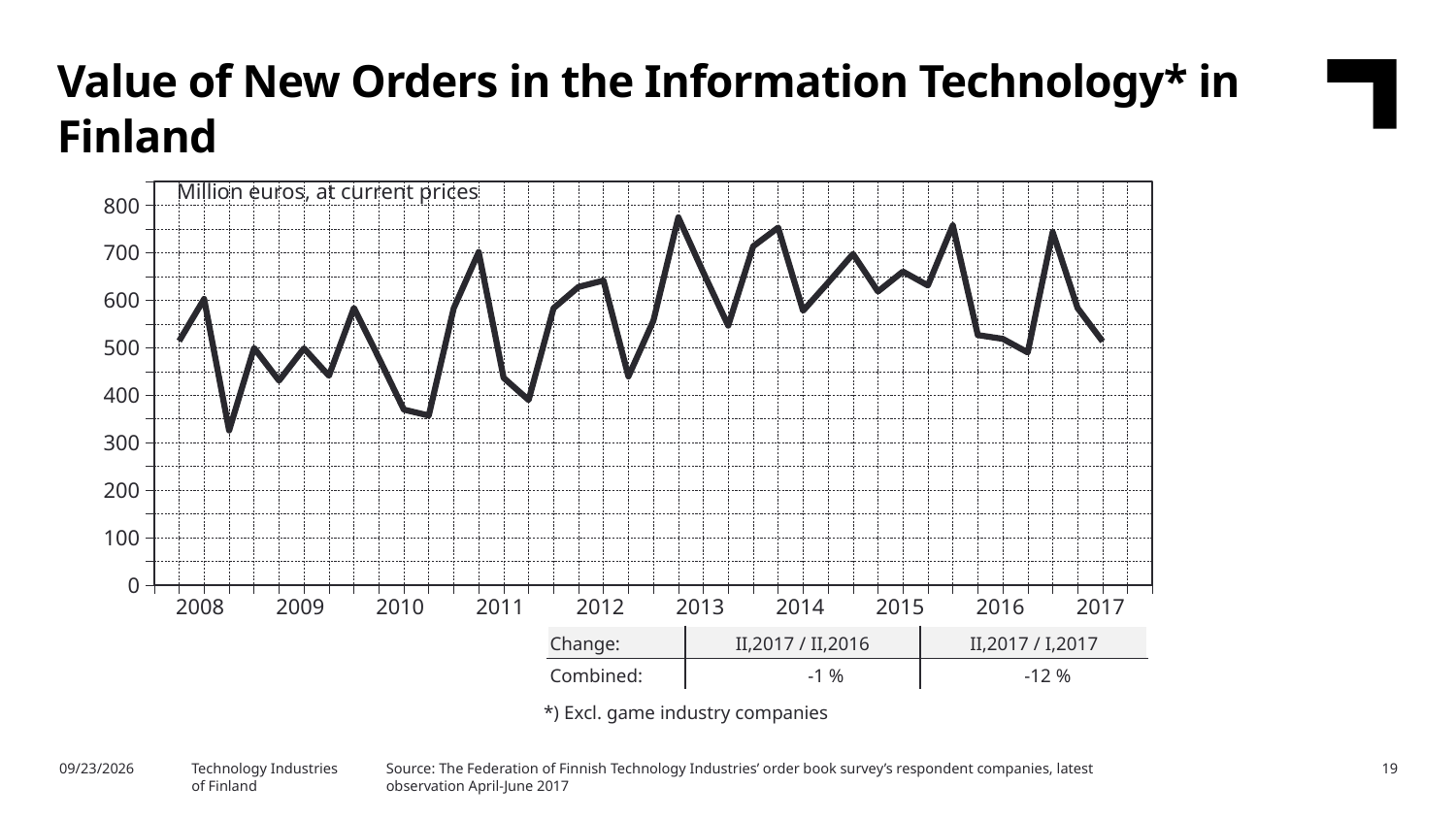
How many year labels are shown along the x axis of the chart? 10 Is the lowest point on the line greater or less than 400? less What is the combined change for II,2017 / II,2016 shown in the table below the chart? -1 % What is the title of the chart on the slide? Value of New Orders in the Information Technology* in Finland Does the line rise or fall from its peak in 2016 to the final point in 2017? fall Is the first plotted value on the line (at 2008) greater or less than 400? greater Is the highest point on the line greater or less than 700? greater In what unit are the values on the chart expressed, according to the label inside the plot area? Million euros, at current prices What kind of chart is shown on the slide? line chart What is the combined change for II,2017 / I,2017 shown in the table below the chart? -12 % Which change in the table is larger in magnitude: II,2017 / II,2016 or II,2017 / I,2017? II,2017 / I,2017